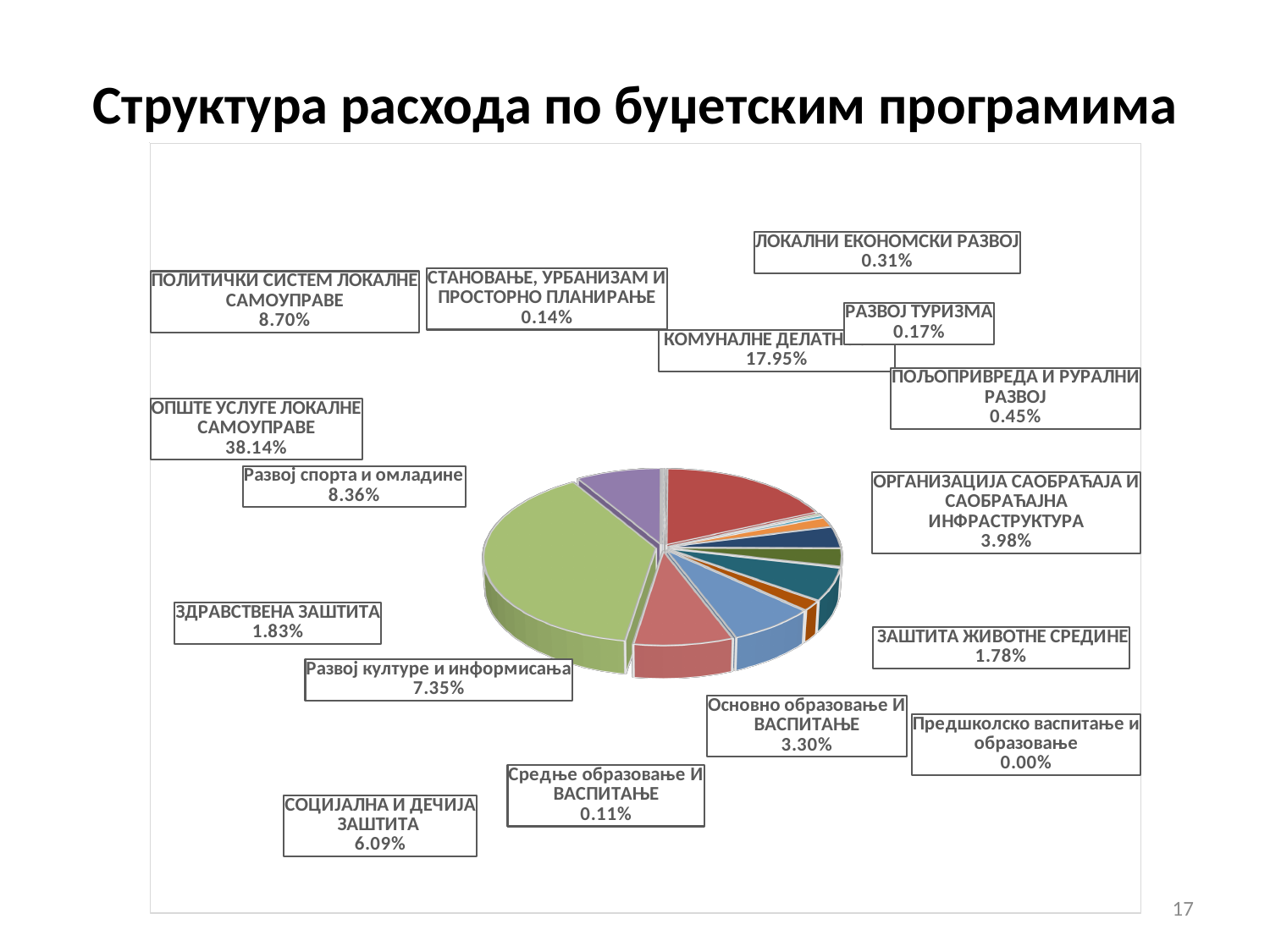
Which category has the largest share of the pie? ОПШТЕ УСЛУГЕ ЛОКАЛНЕ САМОУПРАВЕ What share does Развој културе и информисања have? 7.35% Which category has the smallest share of the pie? Предшколско васпитање и образовање What share does СОЦИЈАЛНА И ДЕЧИЈА ЗАШТИТА have? 6.09% What is the difference in percentage points between ОПШТЕ УСЛУГЕ ЛОКАЛНЕ САМОУПРАВЕ (38.14%) and ПОЛИТИЧКИ СИСТЕМ ЛОКАЛНЕ САМОУПРАВЕ (8.70%)? 29.44 What kind of chart is shown on the slide? pie chart Which is larger: the share for ПОЛИТИЧКИ СИСТЕМ ЛОКАЛНЕ САМОУПРАВЕ or for Развој спорта и омладине? ПОЛИТИЧКИ СИСТЕМ ЛОКАЛНЕ САМОУПРАВЕ What share does ЗАШТИТА ЖИВОТНЕ СРЕДИНЕ have? 1.78% What share does ПОЉОПРИВРЕДА И РУРАЛНИ РАЗВОЈ have? 0.45% What is the title of the chart on the slide? Структура расхода по буџетским програмима What share does ОПШТЕ УСЛУГЕ ЛОКАЛНЕ САМОУПРАВЕ have? 38.14% How many categories are labelled on the pie chart? 16